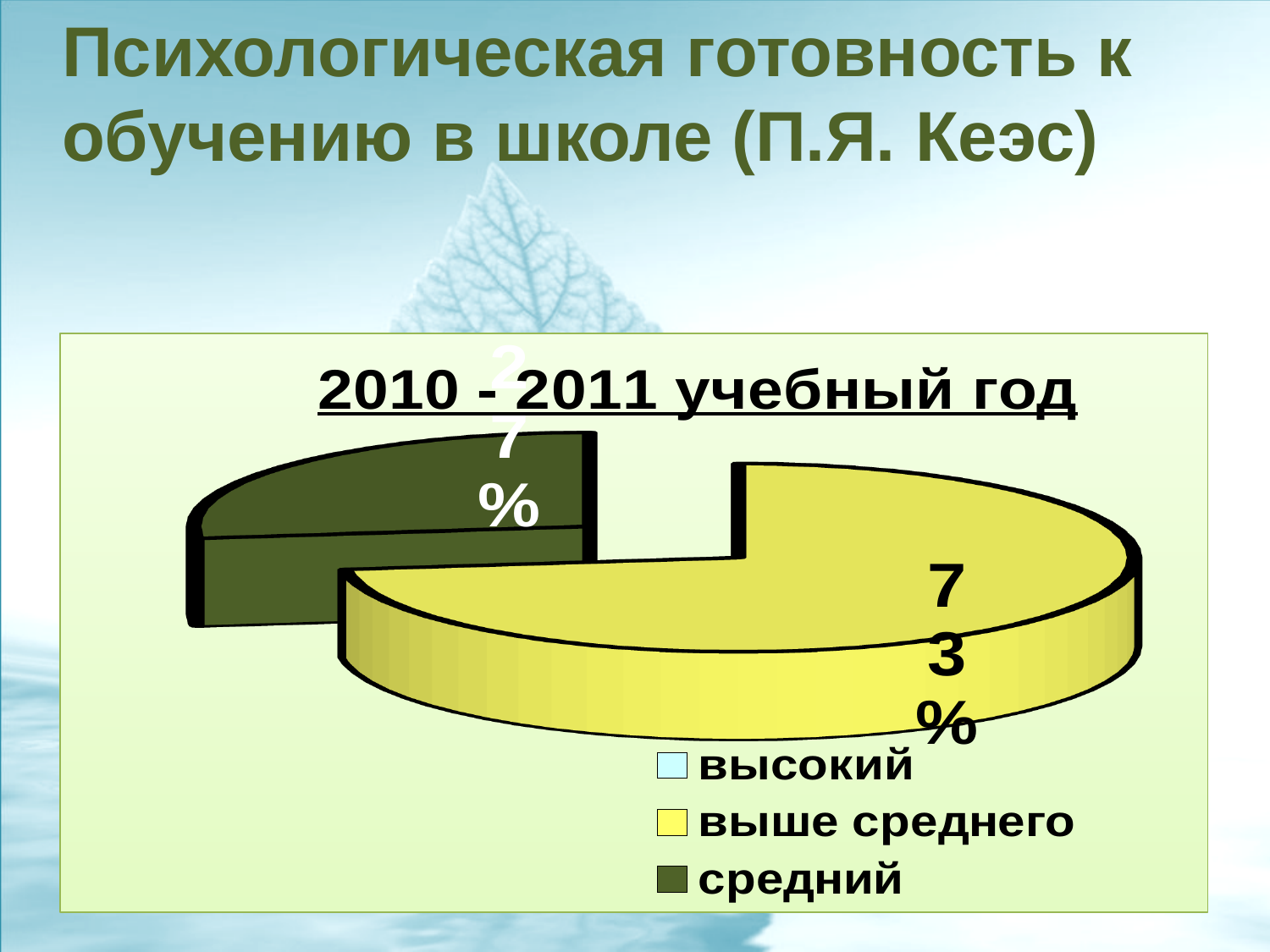
What colour represents the "средний" category in the legend? dark green What is the title of the chart? 2010 - 2011 учебный год Which category has the largest slice of the pie? выше среднего What is the combined share of the "выше среднего" and "средний" slices? 100% Which is larger, the "выше среднего" slice or the "средний" slice? выше среднего What percentage is shown for the "выше среднего" slice? 73% What percentage is shown for the "средний" slice? 27% What kind of chart is shown on the slide? pie chart How many categories are listed in the chart's legend? 3 What share of the pie does the "средний" slice represent? 27% By how many percentage points does the "выше среднего" slice exceed the "средний" slice? 46